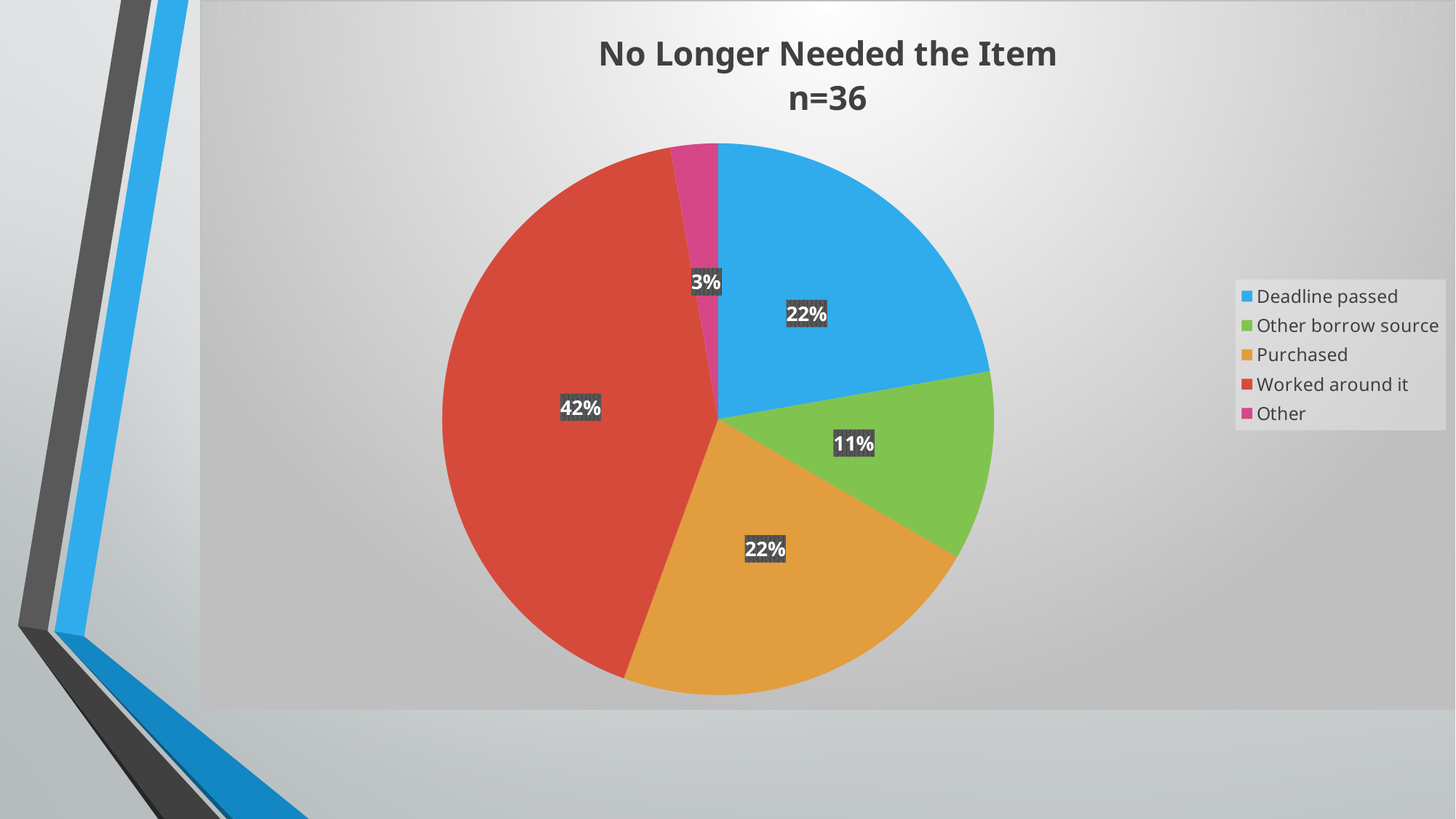
Which is larger, the share for "Other borrow source" or the share for "Deadline passed"? Deadline passed Which category has the largest slice of the pie? Worked around it Which category has the smallest slice of the pie? Other What share of the pie does "Purchased" represent? 22% What share of the pie does "Worked around it" represent? 42% What share of the pie does "Deadline passed" represent? 22% What is the title of the chart? No Longer Needed the Item n=36 What is the difference in percentage points between "Worked around it" and "Purchased"? 20 What type of chart is shown on the slide? pie chart How many categories does the pie chart show? 5